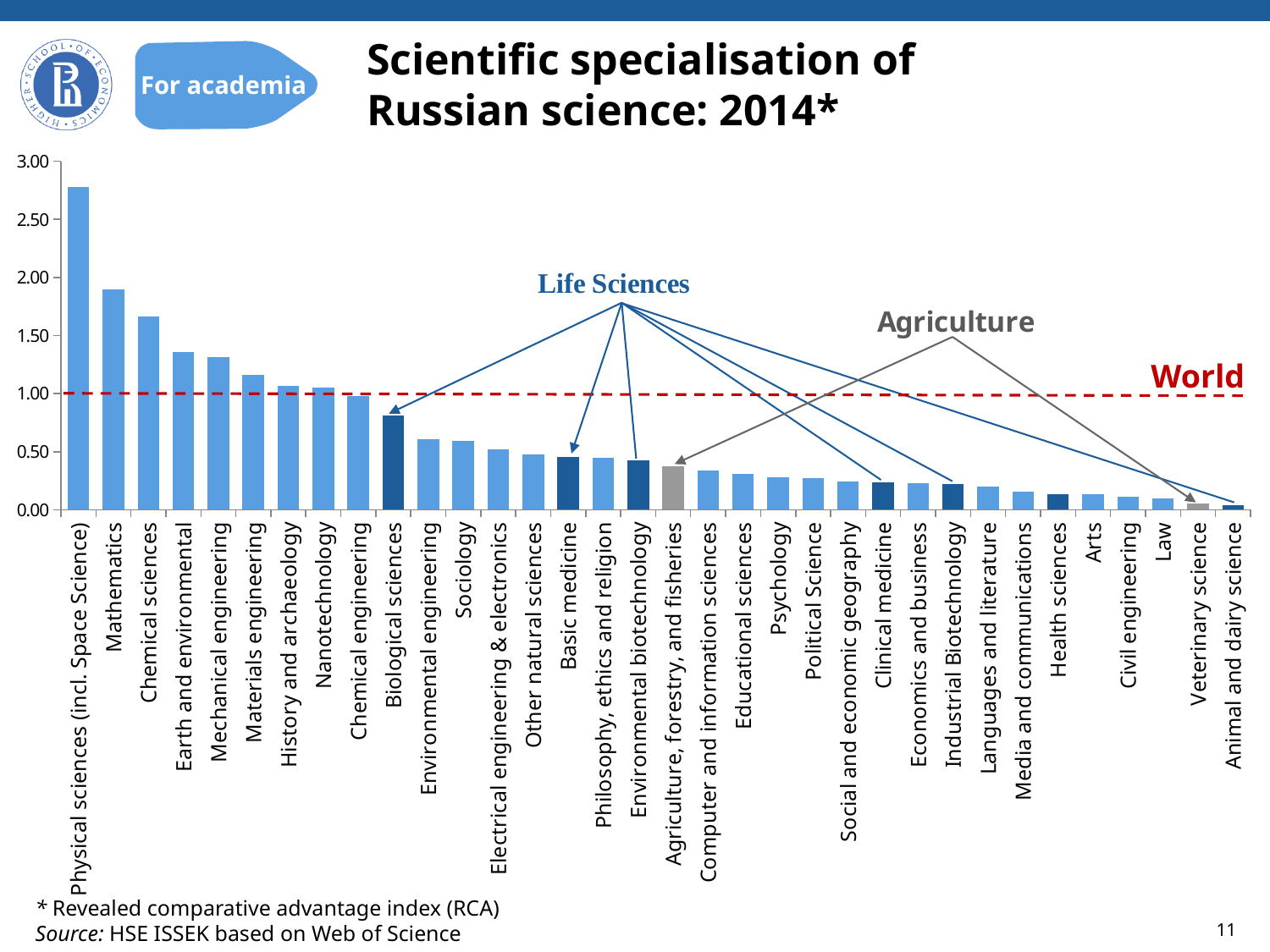
Which field has the highest RCA value? Physical sciences (incl. Space Science) Do the bar values rise or fall from left to right along the x axis? fall Which is larger, the value for Sociology or the value for Psychology? Sociology Is the value for Physical sciences (incl. Space Science) greater or less than 2.50? greater Is the value for Mathematics greater or less than 2.00? less Which is larger, the value for Chemical sciences or the value for Mechanical engineering? Chemical sciences Is the value for Earth and environmental greater or less than 1.00? greater Which field has the lowest RCA value? Animal and dairy science What kind of chart is shown on the slide? bar chart At what value on the y axis is the dashed red 'World' line drawn? 1.00